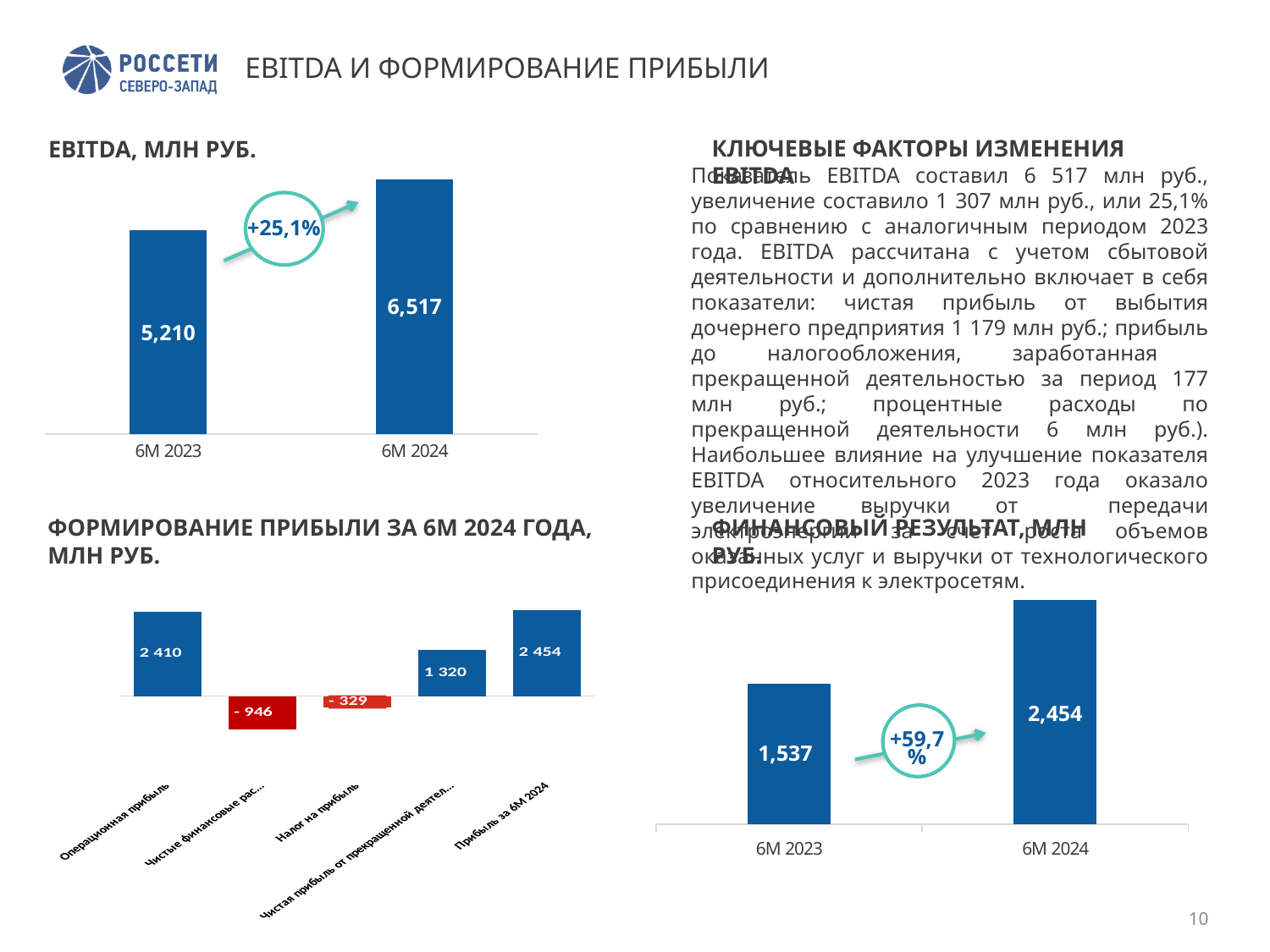
In the ФОРМИРОВАНИЕ ПРИБЫЛИ ЗА 6М 2024 ГОДА chart, what is the value for Налог на прибыль? - 329 In the EBITDA, МЛН РУБ. chart, what is the value for 6M 2023? 5,210 In the EBITDA, МЛН РУБ. chart, what is the value for 6M 2024? 6,517 In the EBITDA, МЛН РУБ. chart, what is the difference between the 6M 2024 and 6M 2023 values? 1,307 In the ФИНАНСОВЫЙ РЕЗУЛЬТАТ, МЛН РУБ. chart, what is the value for 6M 2023? 1,537 In the ФОРМИРОВАНИЕ ПРИБЫЛИ ЗА 6М 2024 ГОДА chart, which category has the lowest value? Чистые финансовые рас... In the EBITDA, МЛН РУБ. chart, what percentage change is shown between 6M 2023 and 6M 2024? +25,1% In the ФОРМИРОВАНИЕ ПРИБЫЛИ ЗА 6М 2024 ГОДА chart, how many categories are shown on the x axis? 5 In the ФИНАНСОВЫЙ РЕЗУЛЬТАТ, МЛН РУБ. chart, which period has the higher value, 6M 2023 or 6M 2024? 6M 2024 What type of chart is the ФИНАНСОВЫЙ РЕЗУЛЬТАТ, МЛН РУБ. chart? Bar chart In the ФОРМИРОВАНИЕ ПРИБЫЛИ ЗА 6М 2024 ГОДА chart, what is the value for Операционная прибыль? 2 410 In the ФОРМИРОВАНИЕ ПРИБЫЛИ ЗА 6М 2024 ГОДА chart, what is the value for Прибыль за 6М 2024? 2 454